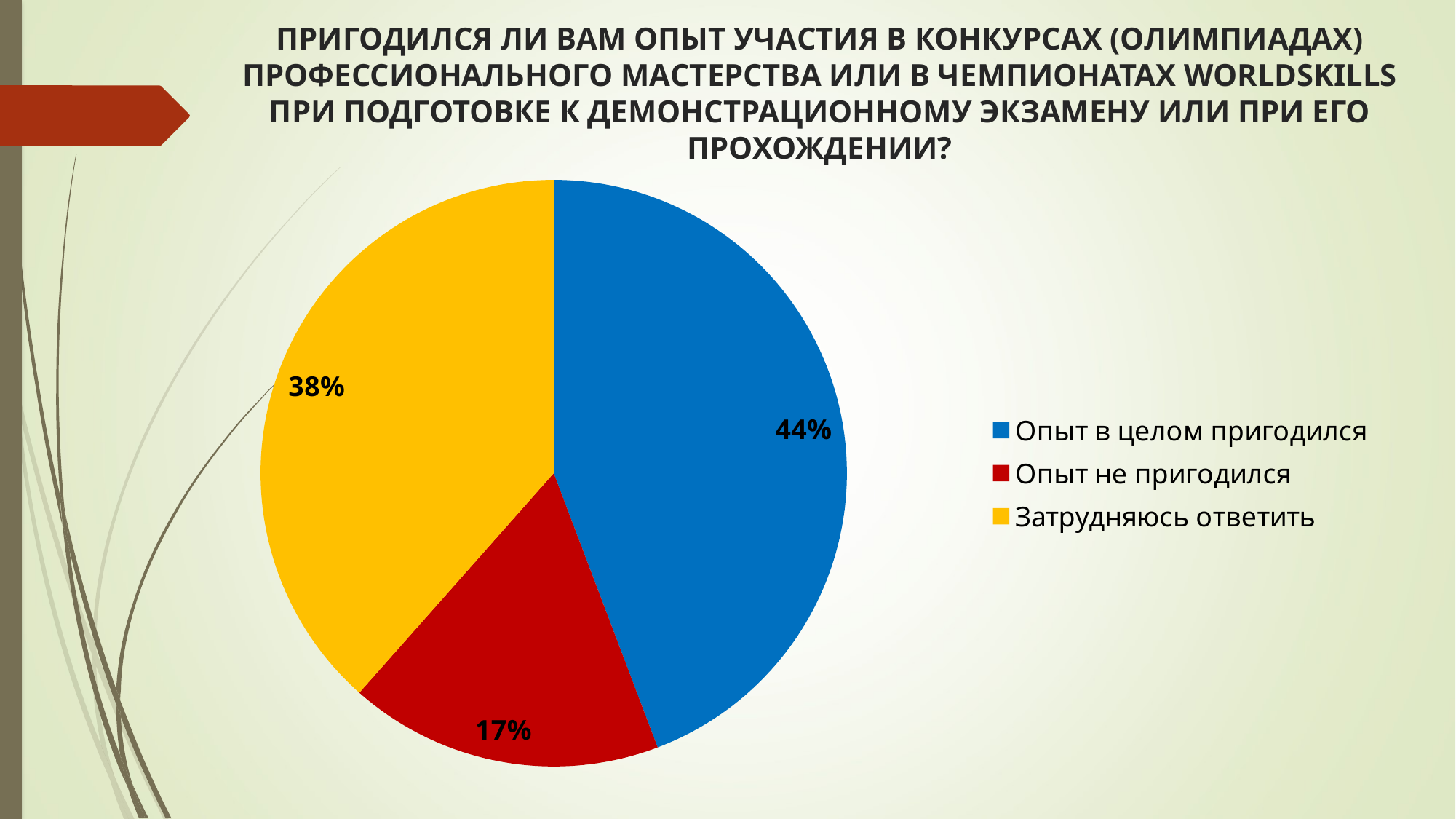
What is the difference in percentage points between "Затрудняюсь ответить" and "Опыт не пригодился"? 21 What share of the pie is labelled "Затрудняюсь ответить"? 38% What share of the pie is labelled "Опыт в целом пригодился"? 44% What colour is the slice for "Затрудняюсь ответить"? yellow What is the difference in percentage points between "Опыт в целом пригодился" and "Опыт не пригодился"? 27 Which category has the largest slice of the pie? Опыт в целом пригодился What kind of chart is shown on the slide? pie chart How many entries does the legend list? 3 What share of the pie is labelled "Опыт не пригодился"? 17% Which is larger: the slice for "Опыт в целом пригодился" or the slice for "Затрудняюсь ответить"? Опыт в целом пригодился How many slices does the pie chart have? 3 Which category has the smallest slice of the pie? Опыт не пригодился